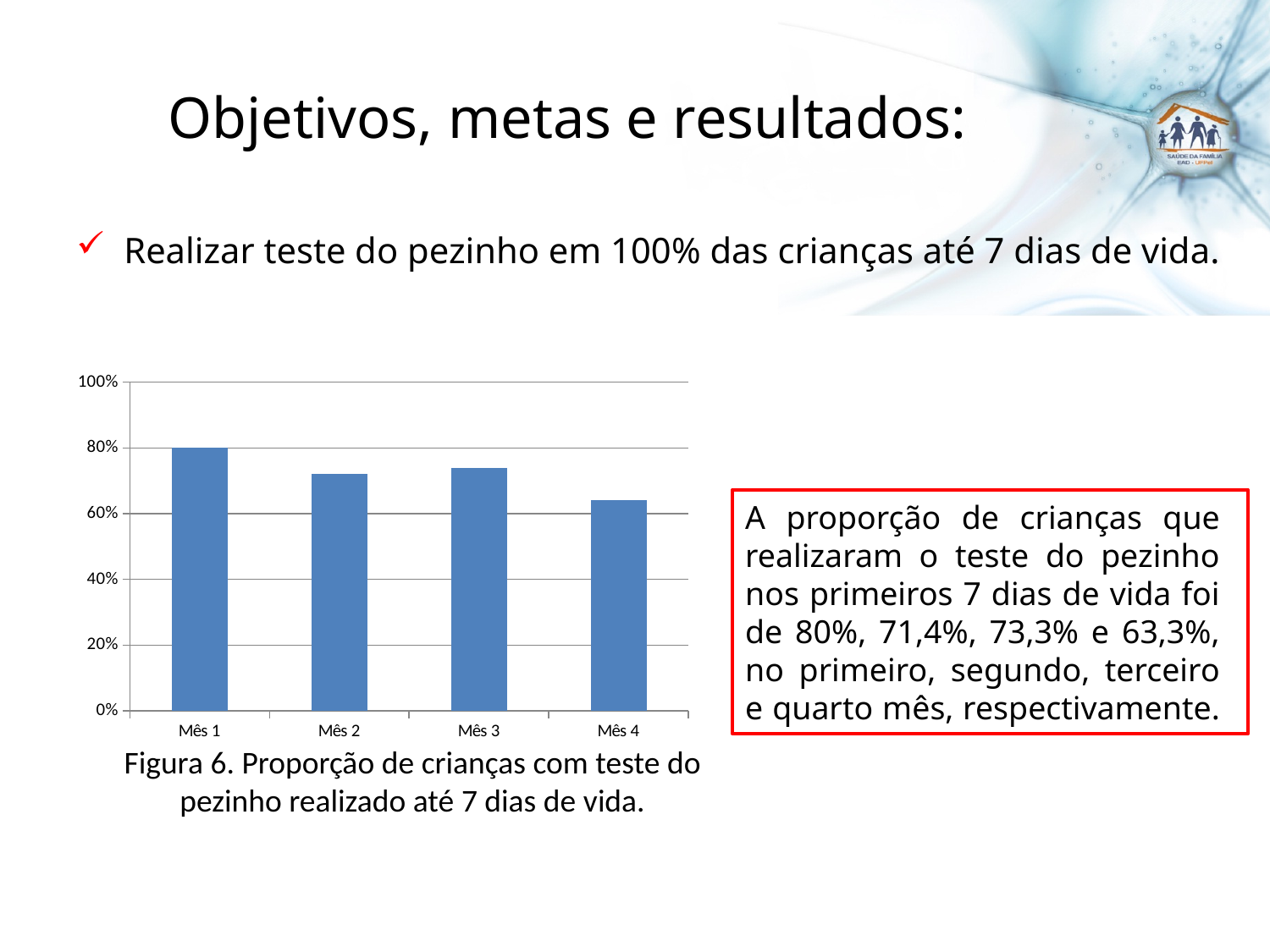
What is the highest value shown on the chart's y axis? 100% Overall, do the values rise or fall from Mês 1 to Mês 4? fall What is the proportion of children with the heel-prick test for Mês 1? 80% What is the proportion for Mês 4 according to the slide? 63,3% Which month has the highest proportion in the chart? Mês 1 Is the value for Mês 2 greater or less than 80%? less What is the proportion for Mês 2 according to the slide? 71,4% Which is larger, the value for Mês 1 or the value for Mês 3? Mês 1 What type of chart is shown in Figura 6? Bar chart Which month has the lowest proportion in the chart? Mês 4 How many months (categories) are plotted on the x axis of the chart? 4 Is the value for Mês 4 greater or less than 60%? greater